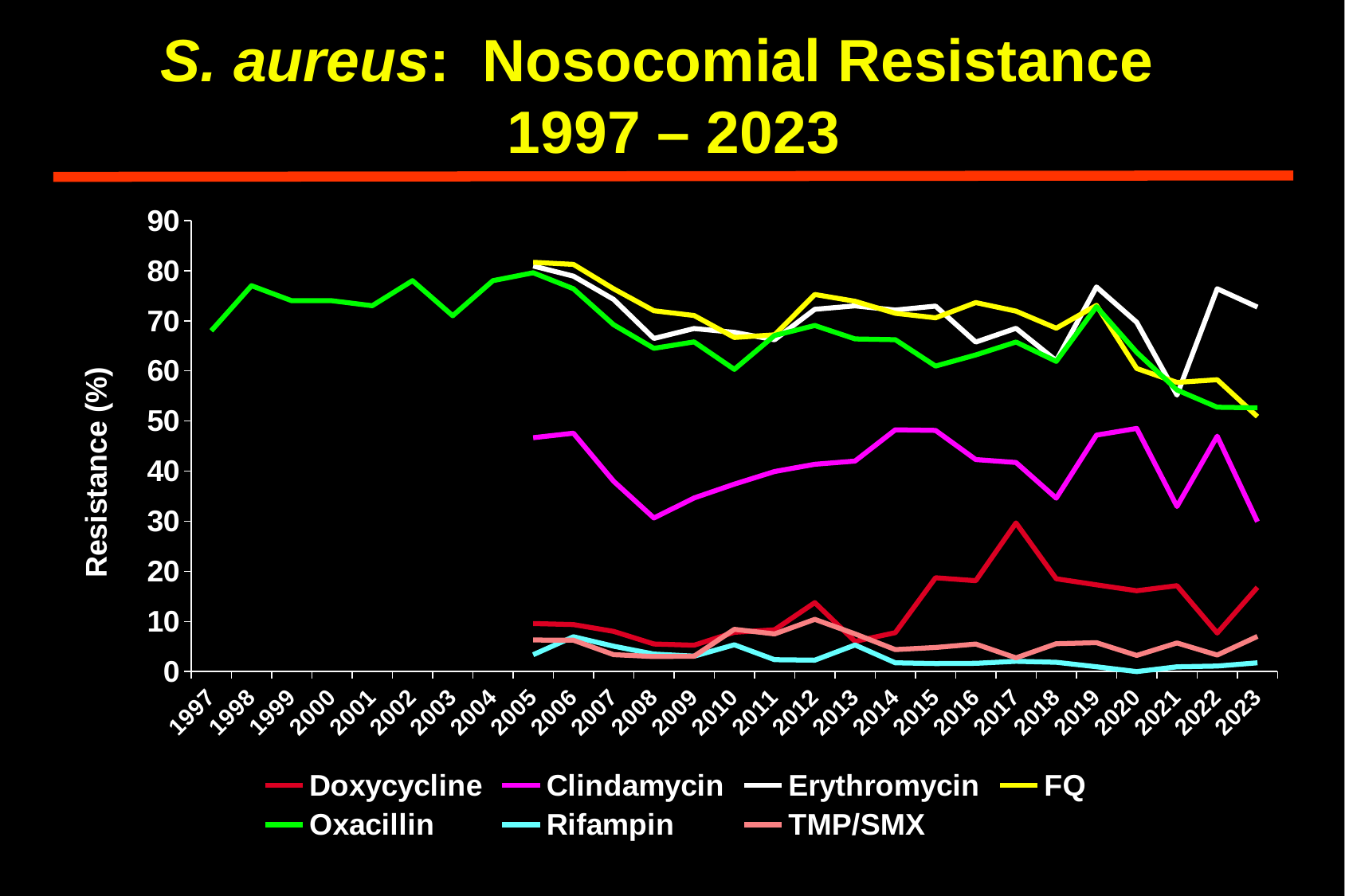
In 2017, which is larger: the value for Clindamycin or the value for Doxycycline? Clindamycin Which series has the highest value in 2023? Erythromycin What kind of chart is shown on the slide? line chart What is the label of the y axis? Resistance (%) In which year does Doxycycline reach its highest value? 2017 Which series has the lowest value in 2023? Rifampin Which series is the only one with data plotted before 2005? Oxacillin How many series does the legend list? 7 Is the value for Oxacillin in 2002 greater or less than 70? greater Is the value for Erythromycin in 2022 greater or less than 70? greater Is the value for Doxycycline in 2022 greater or less than 10? less How many years are shown along the x axis? 27